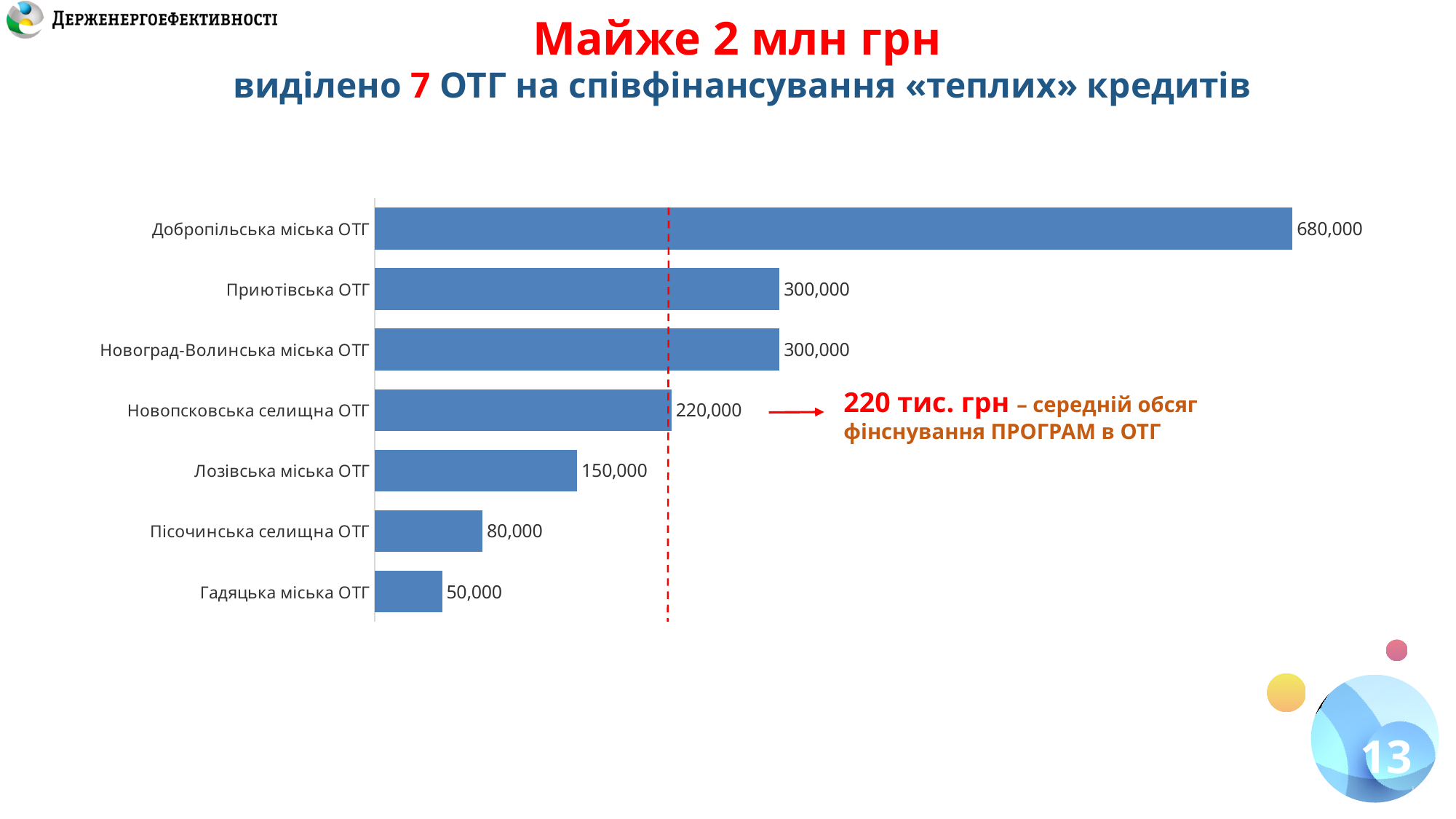
What is the difference between the values for Добропільська міська ОТГ and Приютівська ОТГ? 380,000 What value is shown for Пісочинська селищна ОТГ? 80,000 What kind of chart is shown on the slide? Bar chart What value is shown for Лозівська міська ОТГ? 150,000 What value does the red dashed line on the chart mark, according to the annotation? 220 тис. грн How many ОТГ categories are shown in the chart? 7 What value is shown for Добропільська міська ОТГ? 680,000 Which is larger, the value for Лозівська міська ОТГ or the value for Пісочинська селищна ОТГ? Лозівська міська ОТГ What value is shown for Новоград-Волинська міська ОТГ? 300,000 Which ОТГ has the lowest value? Гадяцька міська ОТГ Which ОТГ has the highest value? Добропільська міська ОТГ What is the difference between the values for Новопсковська селищна ОТГ and Гадяцька міська ОТГ? 170,000